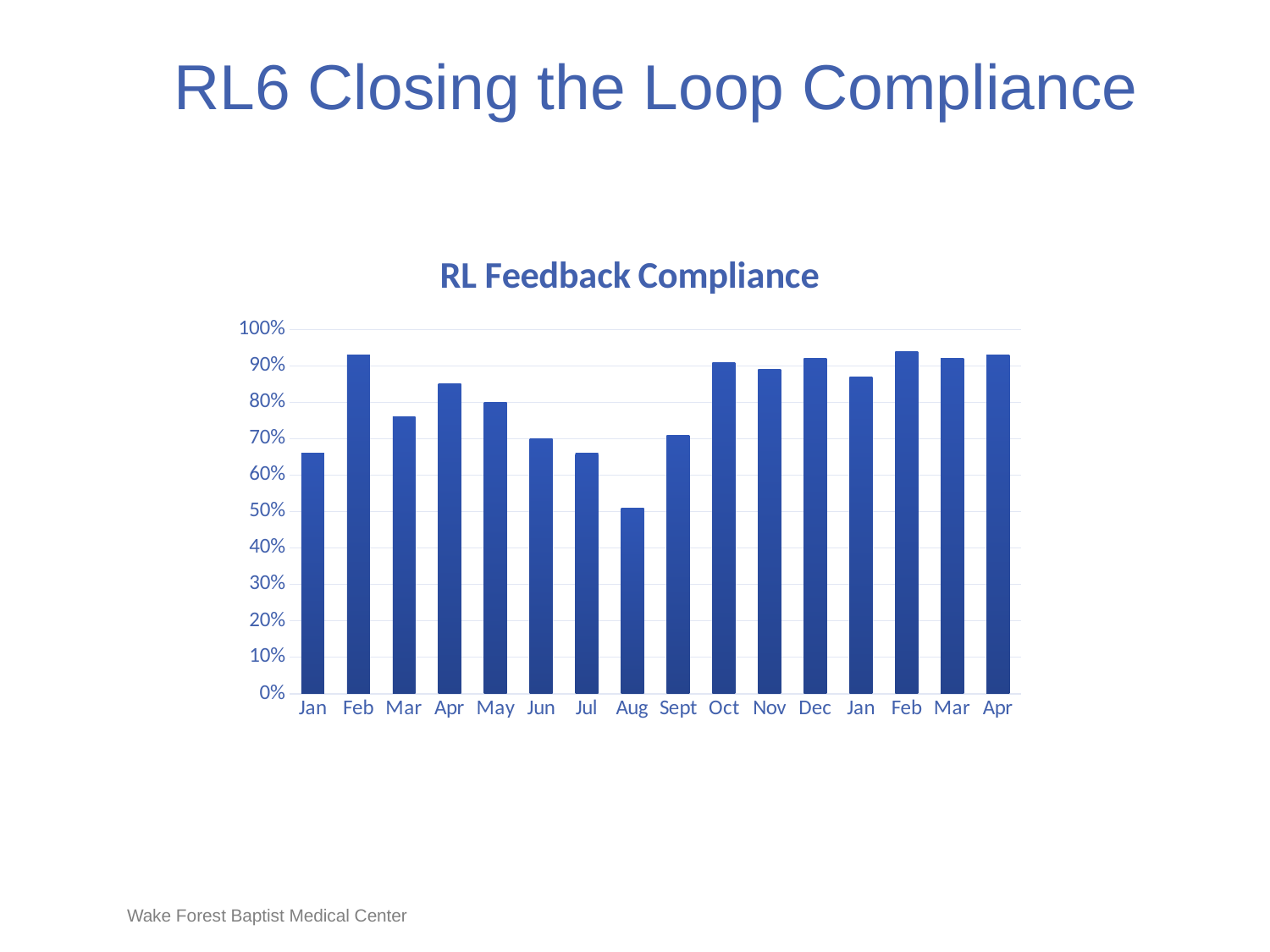
Is the value for Jun greater or less than 80%? less What kind of chart is shown on the slide? bar chart Which is larger, the value for Aug or the value for Dec? Dec Is the value for Oct greater or less than 80%? greater Which is larger, the value for Jul or the value for Apr (the first Apr bar)? Apr Is the value for Aug greater or less than 60%? less How many bars (months) are plotted in the chart? 16 What is the title of the chart? RL Feedback Compliance Do the values rise or fall from Aug to Oct? rise Which month has the lowest compliance value? Aug